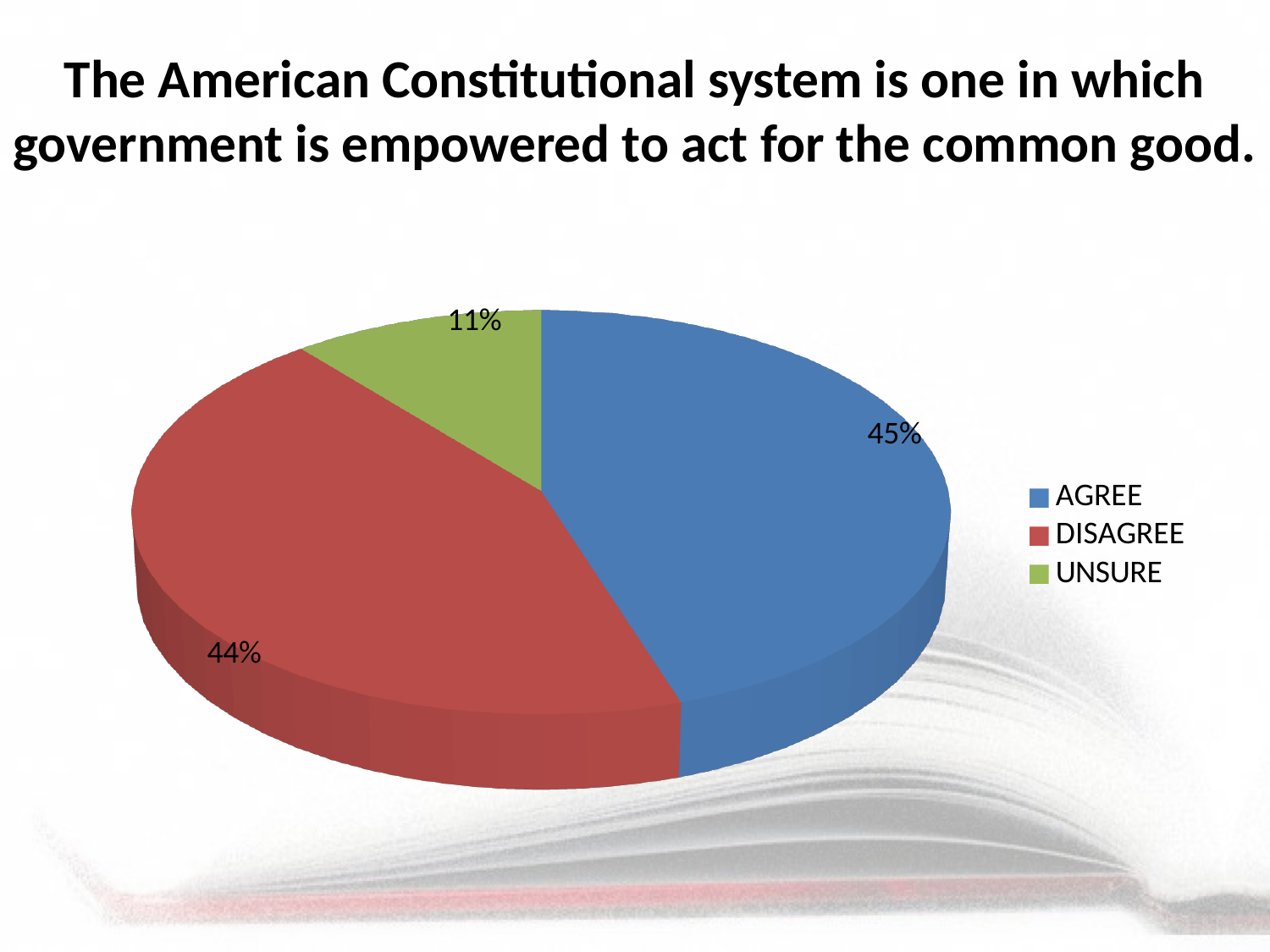
What is the difference in percentage points between AGREE and UNSURE? 34 What percentage of respondents chose UNSURE? 11% What percentage of respondents chose AGREE? 45% Which response has the smallest share of the pie? UNSURE How many entries does the legend list? 3 Which is larger, the share for DISAGREE or the share for UNSURE? DISAGREE Which response has the largest share of the pie? AGREE How many slices does the pie chart have? 3 What is the difference in percentage points between DISAGREE and UNSURE? 33 What kind of chart is shown on the slide? Pie chart What percentage of respondents chose DISAGREE? 44% What colour represents DISAGREE in the pie chart? Red